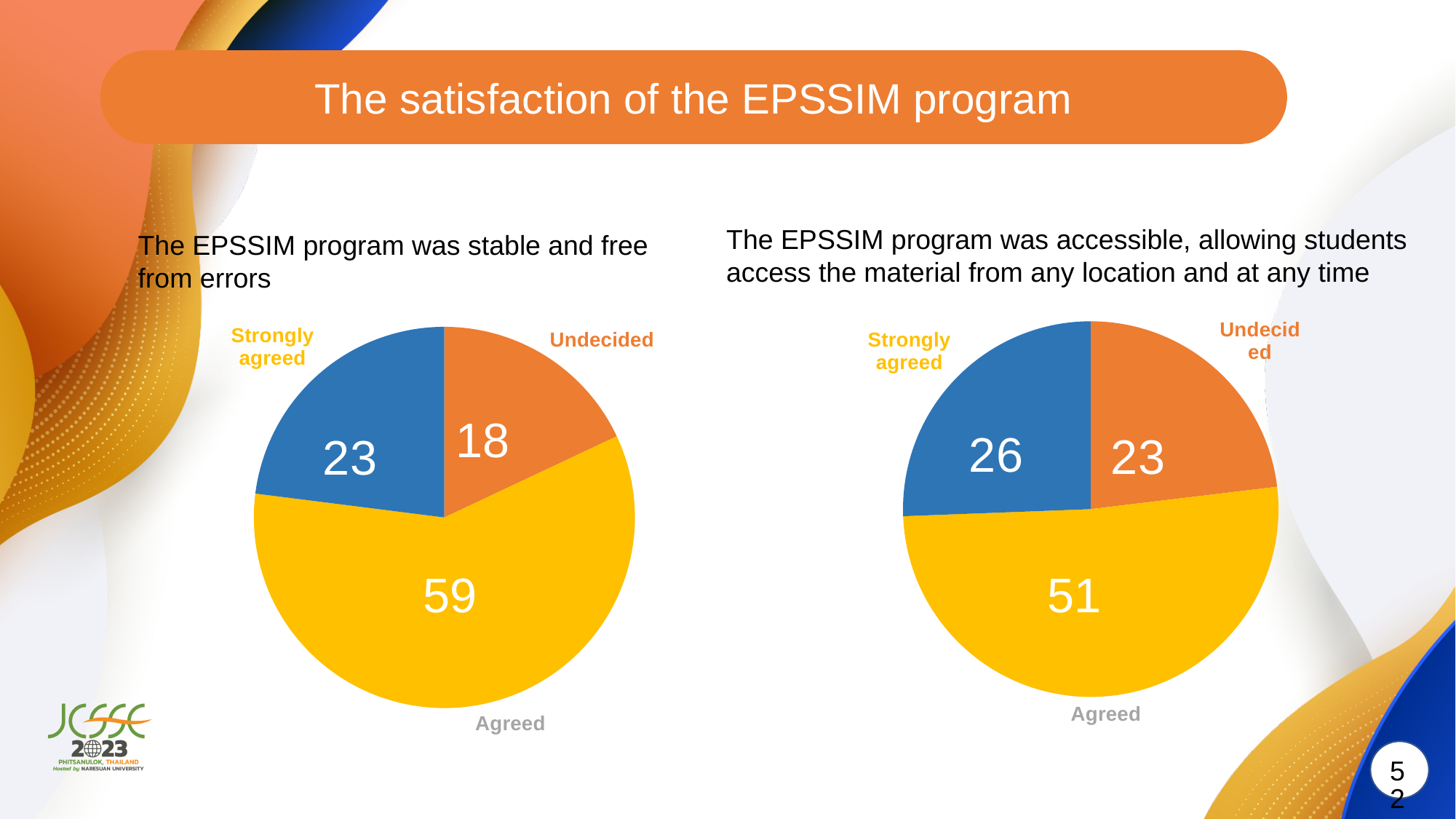
In the right chart (accessible from any location and at any time), what is the value for Undecided? 23 In the left chart (stable and free from errors), what is the difference between Agreed and Strongly agreed? 36 In the left chart (stable and free from errors), which category has the largest slice? Agreed In the right chart (accessible from any location and at any time), what share of the total do the Agreed responses represent? 51% What type of chart is used on this slide? Pie chart In the right chart (accessible from any location and at any time), which category has the smallest slice? Undecided How many slices does the left chart (stable and free from errors) have? 3 In the left chart (stable and free from errors), what is the value for Agreed? 59 In the left chart (stable and free from errors), what is the value for Undecided? 18 Which is larger: Strongly agreed in the left chart or Strongly agreed in the right chart? Right chart (26) In the right chart (accessible from any location and at any time), what is the value for Strongly agreed? 26 In the right chart (accessible from any location and at any time), what is the difference between Agreed and Undecided? 28